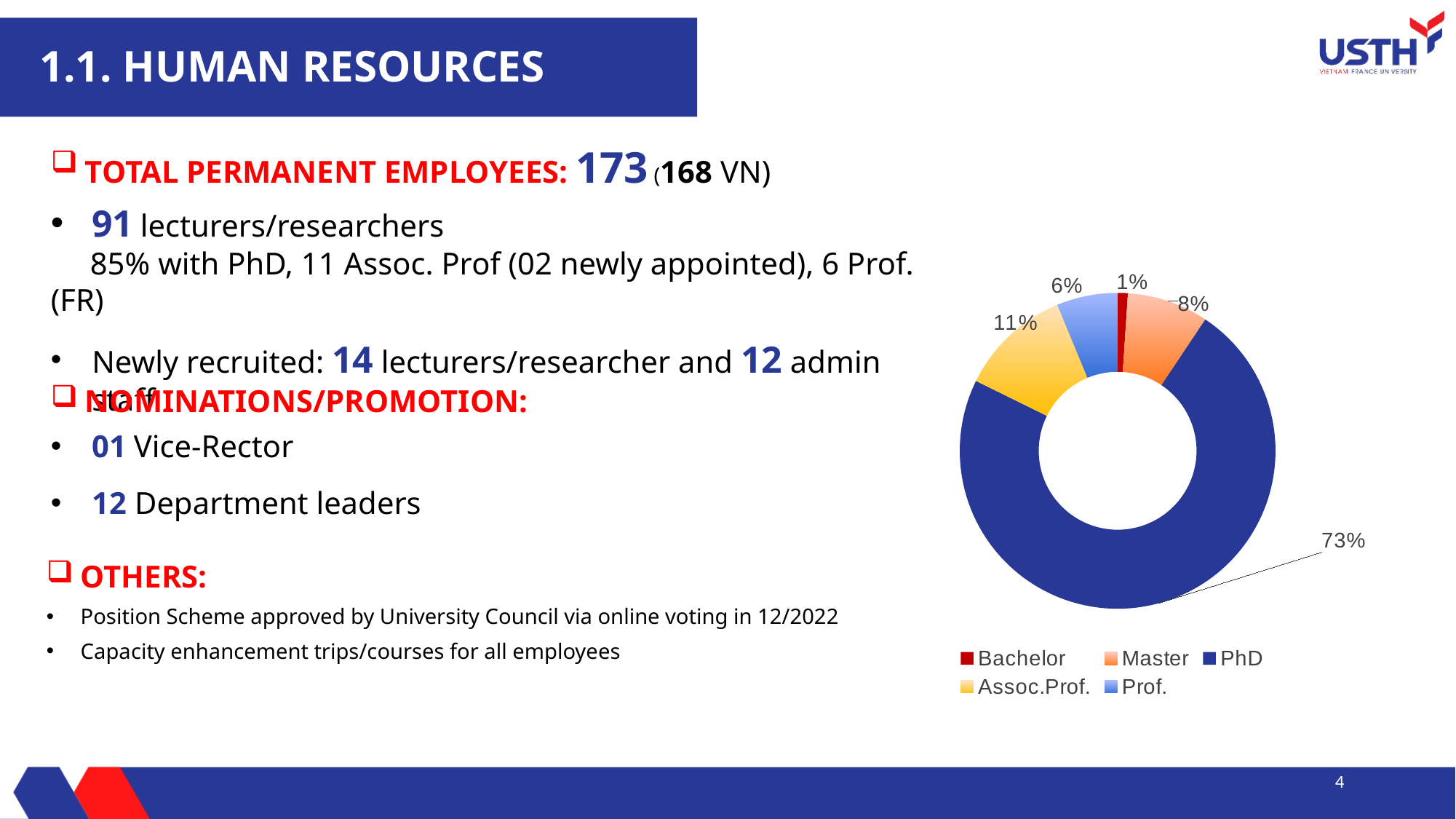
What share of the doughnut chart is PhD? 73% What share of the doughnut chart is Bachelor? 1% Which has a larger share in the doughnut chart, Master or Prof.? Master What share of the doughnut chart is Master? 8% What is the difference in percentage points between the PhD share and the Assoc.Prof. share? 62 What kind of chart is shown on the slide? Doughnut (pie) chart How many categories does the doughnut chart show? 5 What share of the doughnut chart is Prof.? 6% Which colour represents PhD in the chart legend? Dark blue Which category has the largest share in the doughnut chart? PhD Which category has the smallest share in the doughnut chart? Bachelor What share of the doughnut chart is Assoc.Prof.? 11%